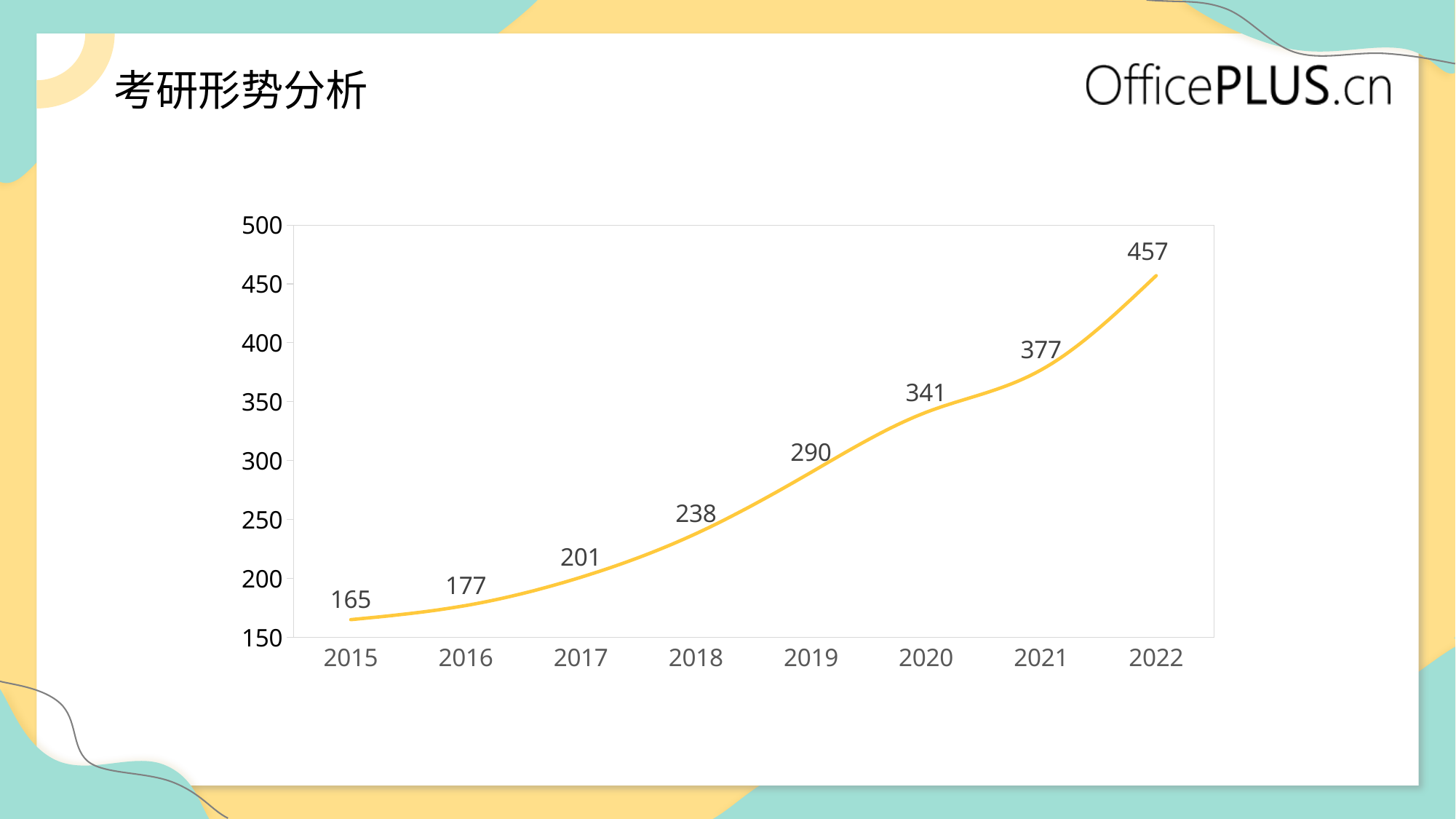
Which year has the lowest value? 2015 What is the value for 2022? 457 How many years are plotted on the chart? 8 What kind of chart is shown on the slide? line chart Which year has the highest value? 2022 What is the value for 2015? 165 Which is larger, the value for 2020 or the value for 2018? 2020 What is the difference between the values for 2022 and 2021? 80 Do the values rise or fall from 2015 to 2022? rise What is the difference between the values for 2018 and 2017? 37 What is the value for 2019? 290 Is the value for 2021 greater or less than 350? greater